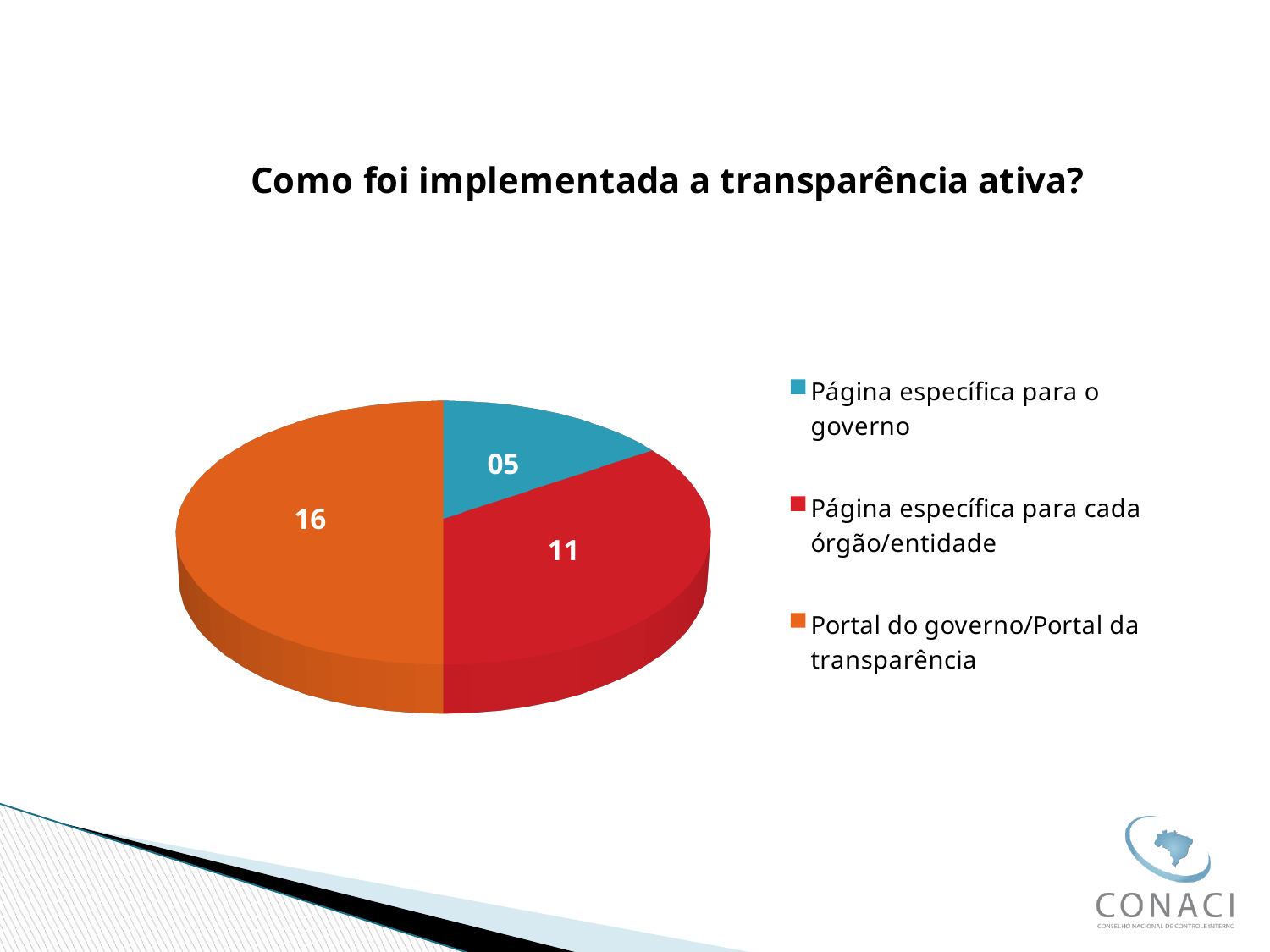
What is the difference between the values for "Portal do governo/Portal da transparência" and "Página específica para cada órgão/entidade"? 5 What is the total of all the slices in the pie chart? 32 What share of the pie does "Portal do governo/Portal da transparência" represent? 50% What is the title of the chart? Como foi implementada a transparência ativa? Which category has the smallest slice of the pie? Página específica para o governo What kind of chart is shown on the slide? Pie chart What is the value for "Portal do governo/Portal da transparência"? 16 Which is larger: the value for "Página específica para cada órgão/entidade" or the value for "Página específica para o governo"? Página específica para cada órgão/entidade Which category has the largest slice of the pie? Portal do governo/Portal da transparência What is the value for "Página específica para o governo"? 05 What is the value for "Página específica para cada órgão/entidade"? 11 How many categories does the pie chart have? 3